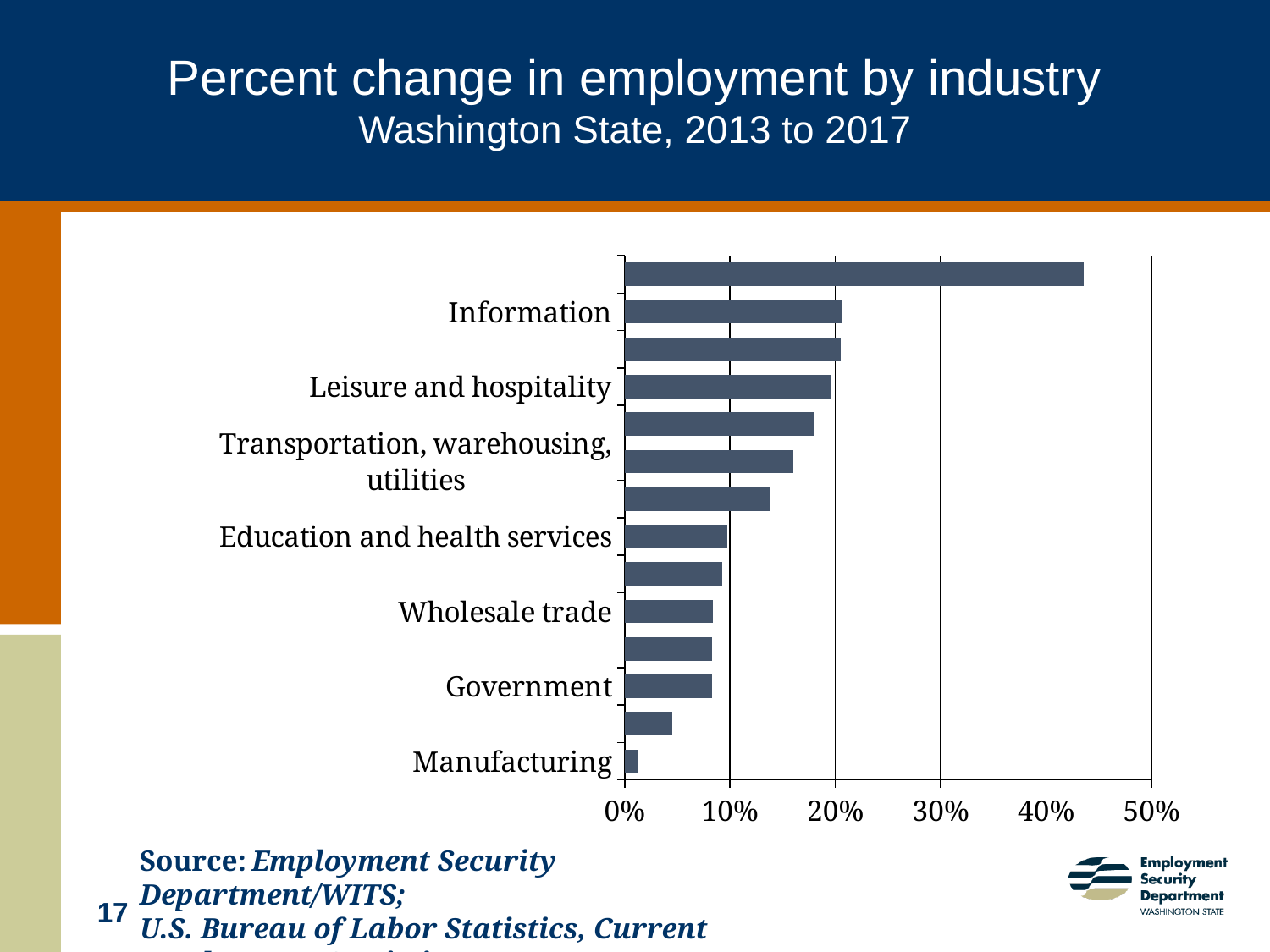
Which labeled industry has the lowest percent change in employment? Manufacturing Is the value for Manufacturing greater or less than 10%? less How many bars are plotted in the chart? 14 Is the value for Information greater or less than 30%? less Is the value for Wholesale trade greater or less than 10%? less What is the title of the chart on the slide? Percent change in employment by industry, Washington State, 2013 to 2017 What kind of chart is shown on the slide? bar chart Which has a larger percent change in employment, Leisure and hospitality or Government? Leisure and hospitality Which has a larger percent change in employment, Information or Manufacturing? Information